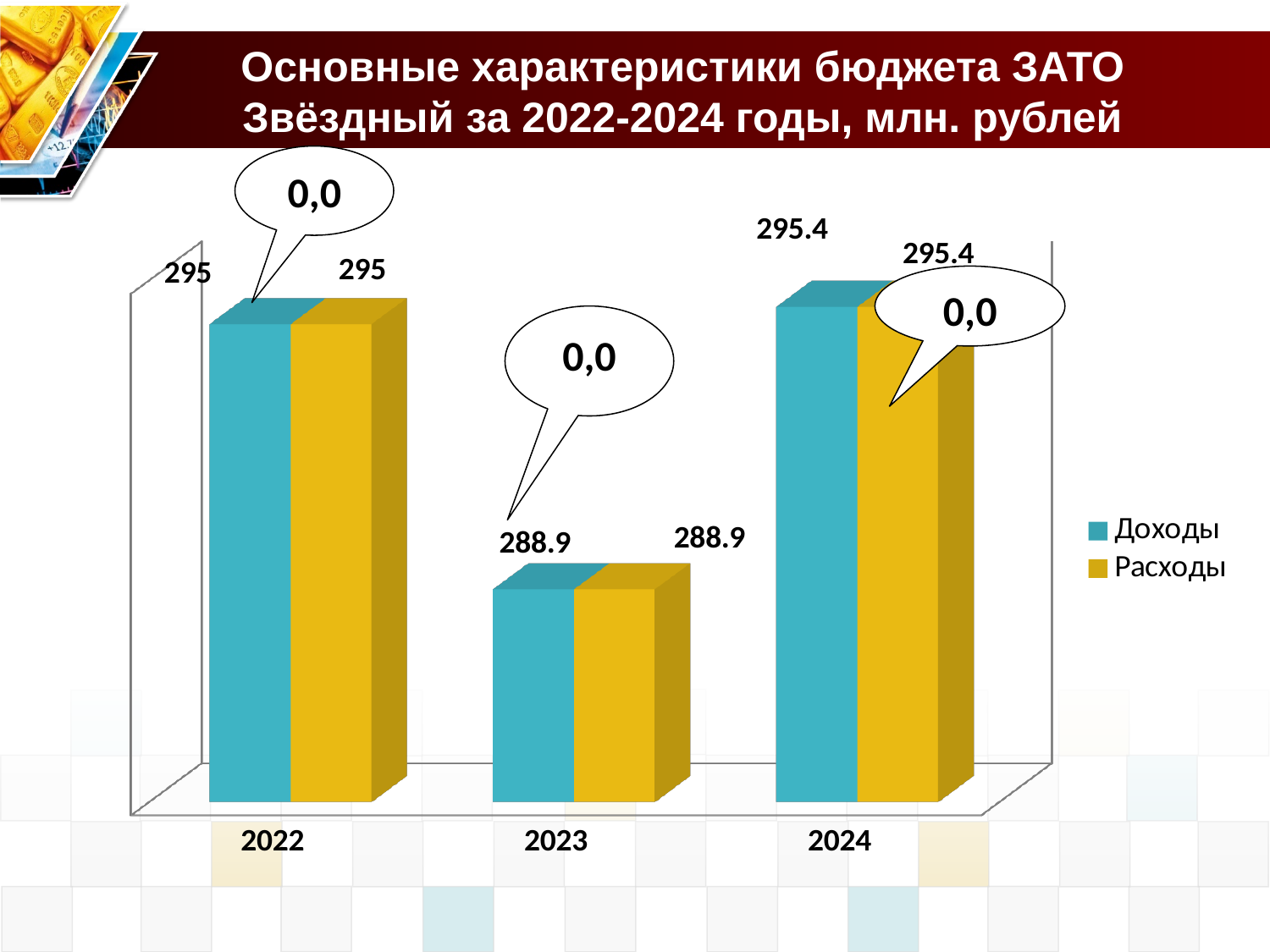
What is the value of Доходы for 2022? 295 What are the two series named in the legend? Доходы and Расходы What is the difference between Доходы in 2024 and Доходы in 2023? 6.5 What is the value of Расходы for 2023? 288.9 What kind of chart is shown on the slide? bar chart How many years are shown on the x axis? 3 How many series does the legend list? 2 What is the value of Доходы for 2024? 295.4 What is the value of Расходы for 2024? 295.4 Which year has the lowest value for Доходы? 2023 Which year has the highest value for Расходы? 2024 Which is larger: Расходы in 2022 or Расходы in 2023? 2022